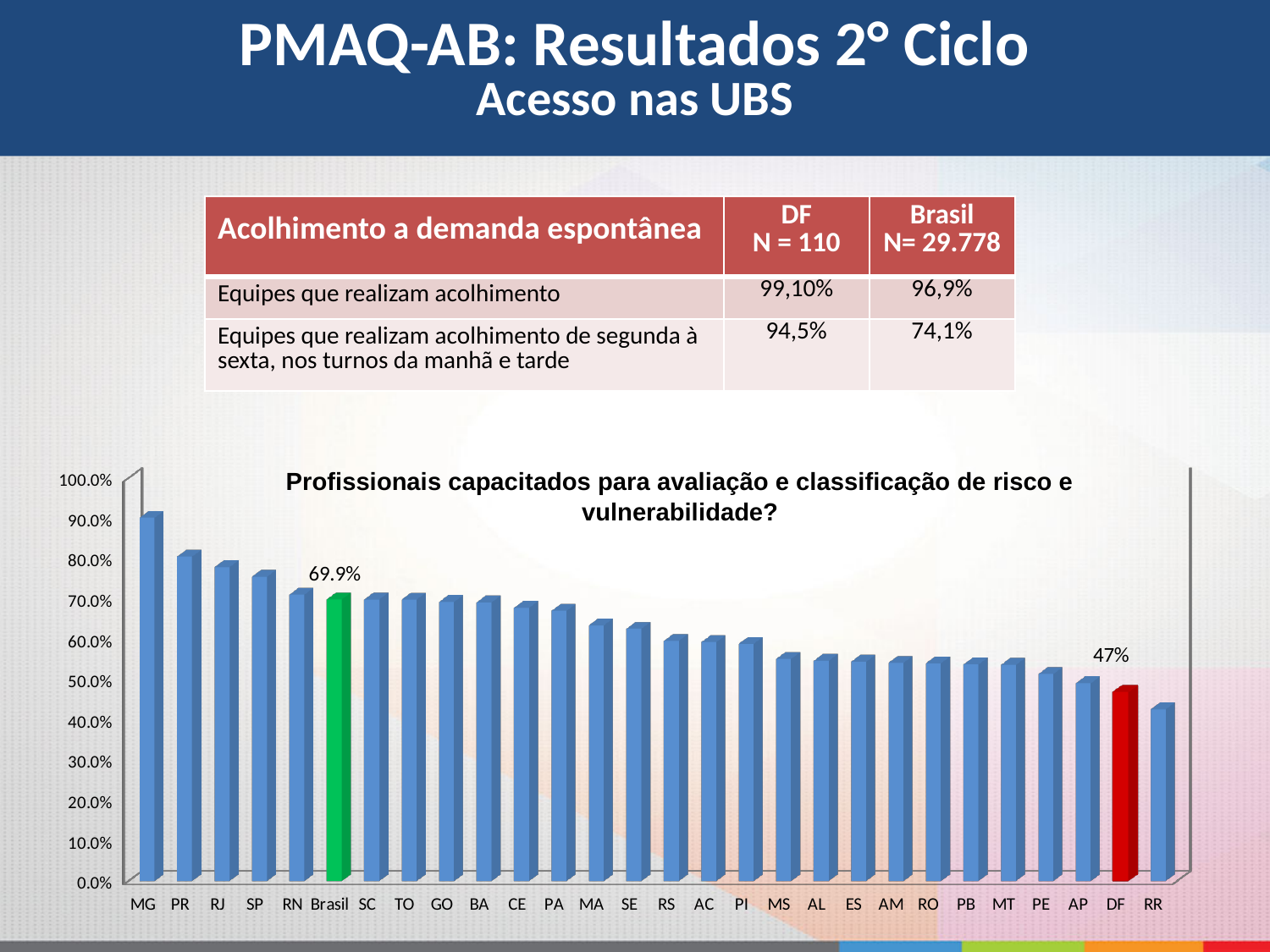
How many categories (bars) are shown in the chart? 28 Which category has the highest bar in the chart? MG What colour is the bar for DF in the chart? red What is the value shown for DF in the chart? 47% Which has a higher value in the chart, MG or RR? MG Do the bar values rise or fall from left to right along the x axis? fall Is the value for RR greater or less than 50.0%? less What type of chart is shown on the slide? bar chart What is the difference between the Brasil value and the DF value in the chart? 22.9 percentage points What is the value shown for Brasil in the chart? 69.9% Is the value for MG greater or less than 80.0%? greater Which category has the lowest bar in the chart? RR